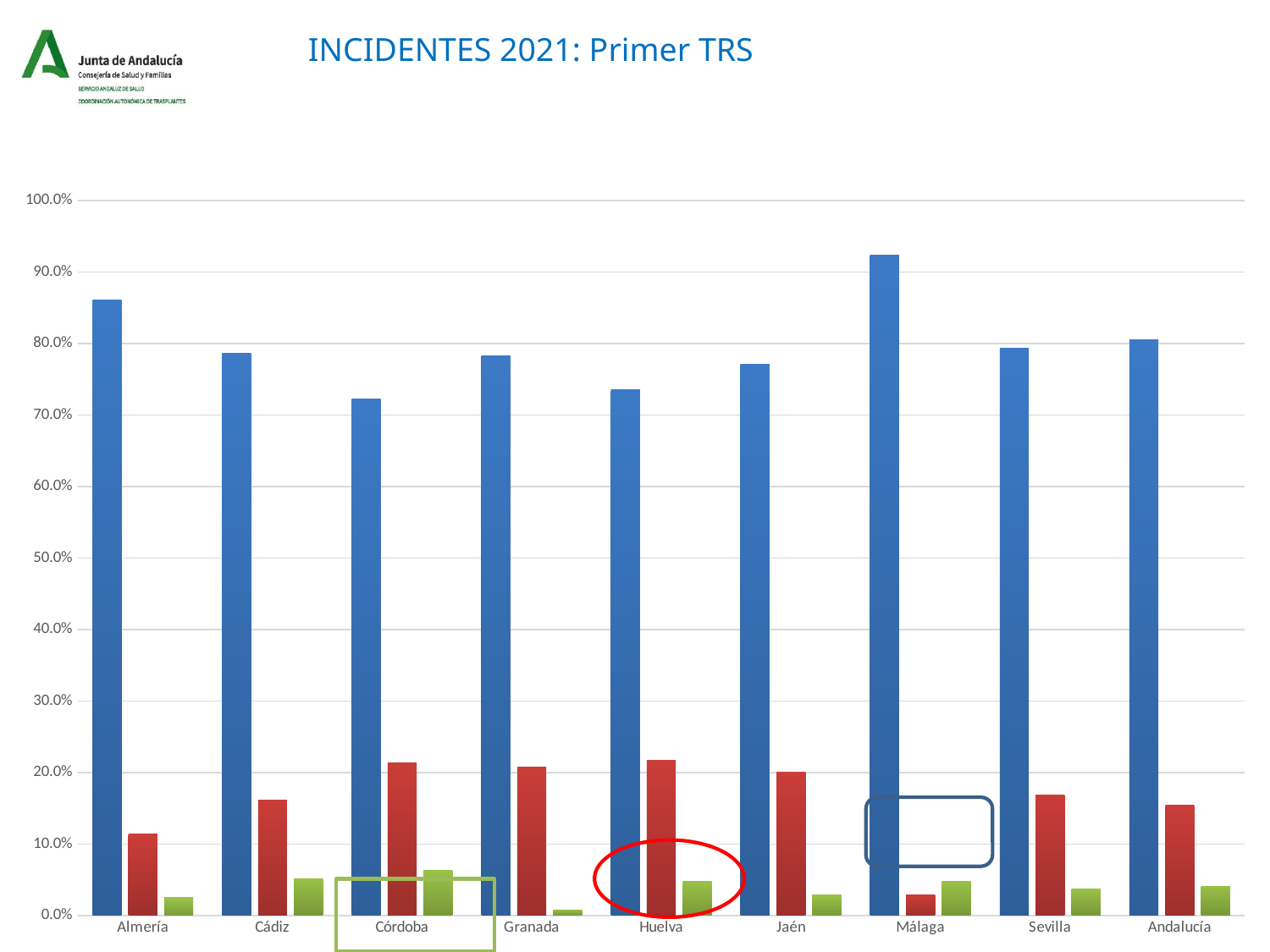
Which has the taller blue bar, Almería or Cádiz? Almería What is the title of the slide containing the chart? INCIDENTES 2021: Primer TRS What kind of chart is shown on the slide? bar chart How many categories are shown on the x axis of the chart? 9 Is the blue bar for Almería greater or less than 80.0%? greater Which category has the tallest blue bar? Málaga Which category has the shortest red bar? Málaga Which category has the shortest green bar? Granada Is the green bar for Granada greater or less than 10.0%? less Is the blue bar for Málaga greater or less than 90.0%? greater Which has the taller red bar, Jaén or Málaga? Jaén